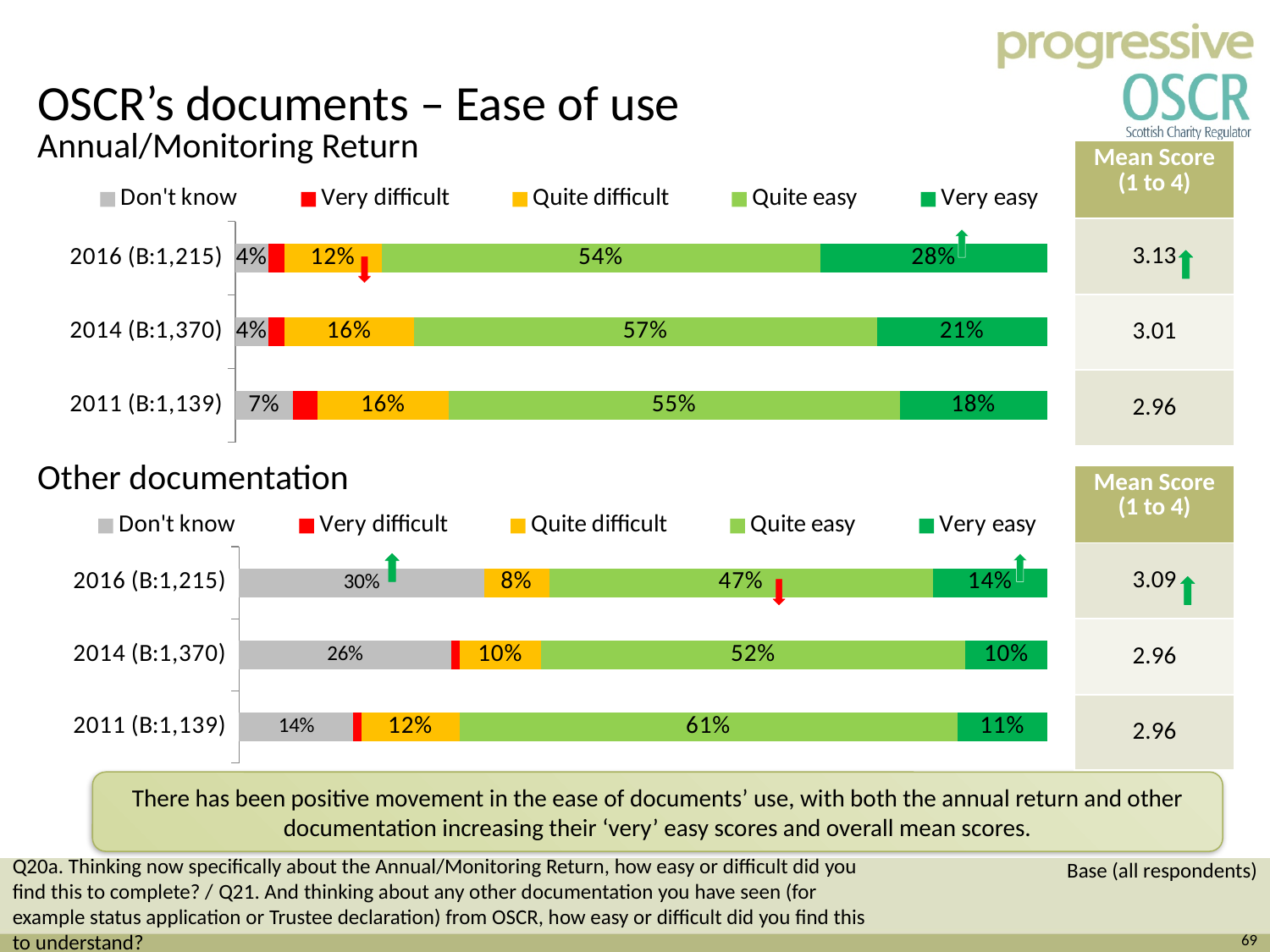
In the Annual/Monitoring Return chart, what percentage of 2016 (B:1,215) respondents found it Quite easy? 54% In the Annual/Monitoring Return chart, which year has the highest Very easy value? 2016 (B:1,215) In the Other documentation chart, what is the Don't know value for 2016 (B:1,215)? 30% In the Annual/Monitoring Return chart, what is the Very easy value for 2011 (B:1,139)? 18% In the Other documentation chart, which year has the larger Quite easy value, 2014 (B:1,370) or 2016 (B:1,215)? 2014 (B:1,370) In the Other documentation chart, what is the Quite easy value for 2011 (B:1,139)? 61% In the Annual/Monitoring Return chart, by how many percentage points did the Very easy value increase from 2014 (B:1,370) to 2016 (B:1,215)? 7 percentage points In the Other documentation chart, does the Don't know value rise or fall from 2011 to 2016? Rise How many years (categories) are shown in the Annual/Monitoring Return chart? 3 In the Other documentation chart, which year has the lowest Don't know value? 2011 (B:1,139) What kind of chart is the Annual/Monitoring Return chart? Stacked bar chart How many series does the legend of the Other documentation chart list? 5